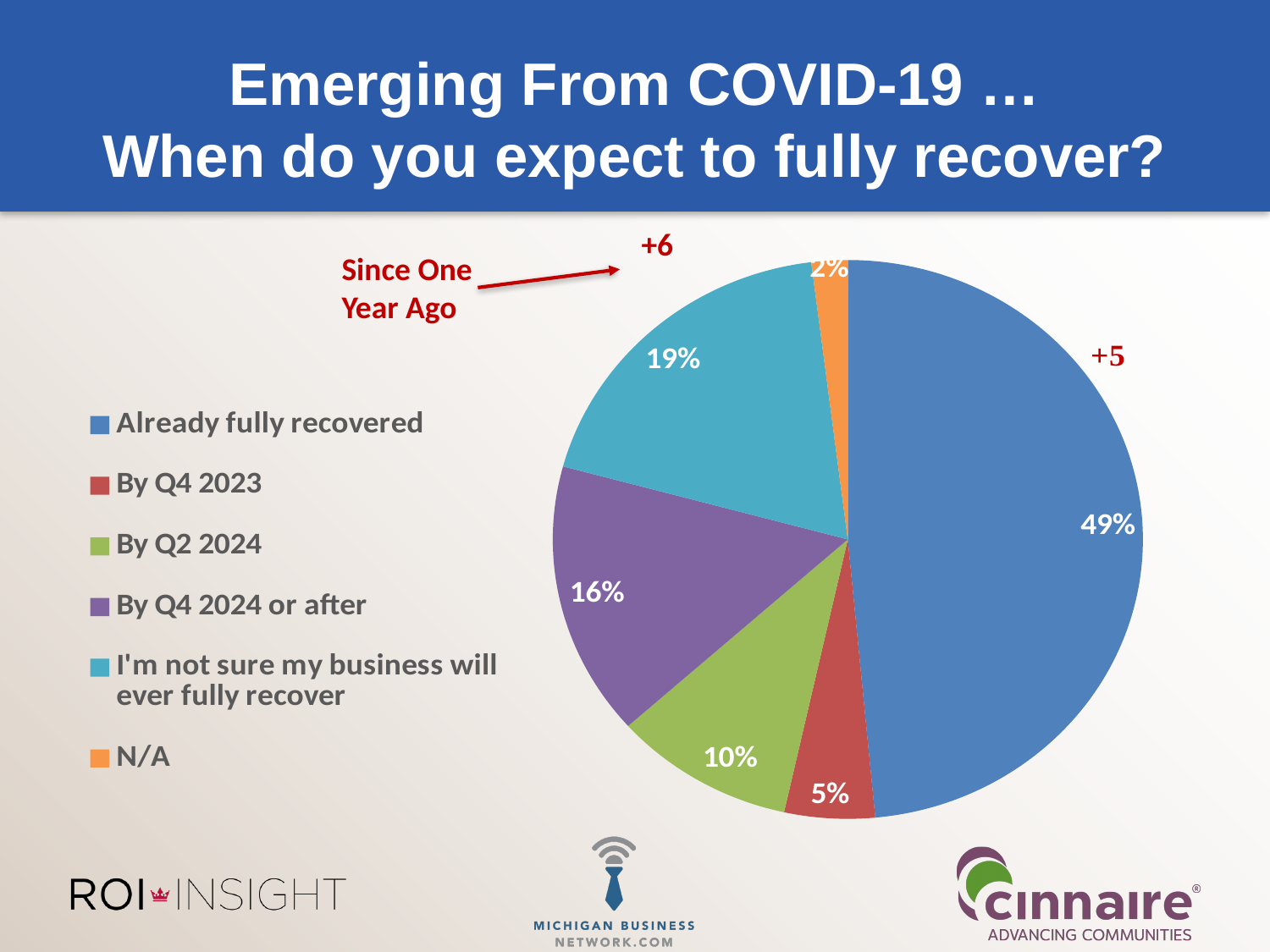
Which response category has the largest share of the pie? Already fully recovered What percentage of respondents answered N/A? 2% What is the difference in percentage points between 'Already fully recovered' and 'I'm not sure my business will ever fully recover'? 30 percentage points Which is larger: the share for 'By Q4 2024 or after' or the share for 'By Q2 2024'? By Q4 2024 or after How many categories does the legend list? 6 What percentage of respondents expect to recover by Q4 2023? 5% What kind of chart is shown on the slide? Pie chart What percentage of respondents are not sure their business will ever fully recover? 19% What percentage of respondents expect to recover by Q2 2024? 10% Which response category has the smallest share of the pie? N/A What share of respondents said they have already fully recovered? 49% What percentage of respondents expect to recover by Q4 2024 or after? 16%